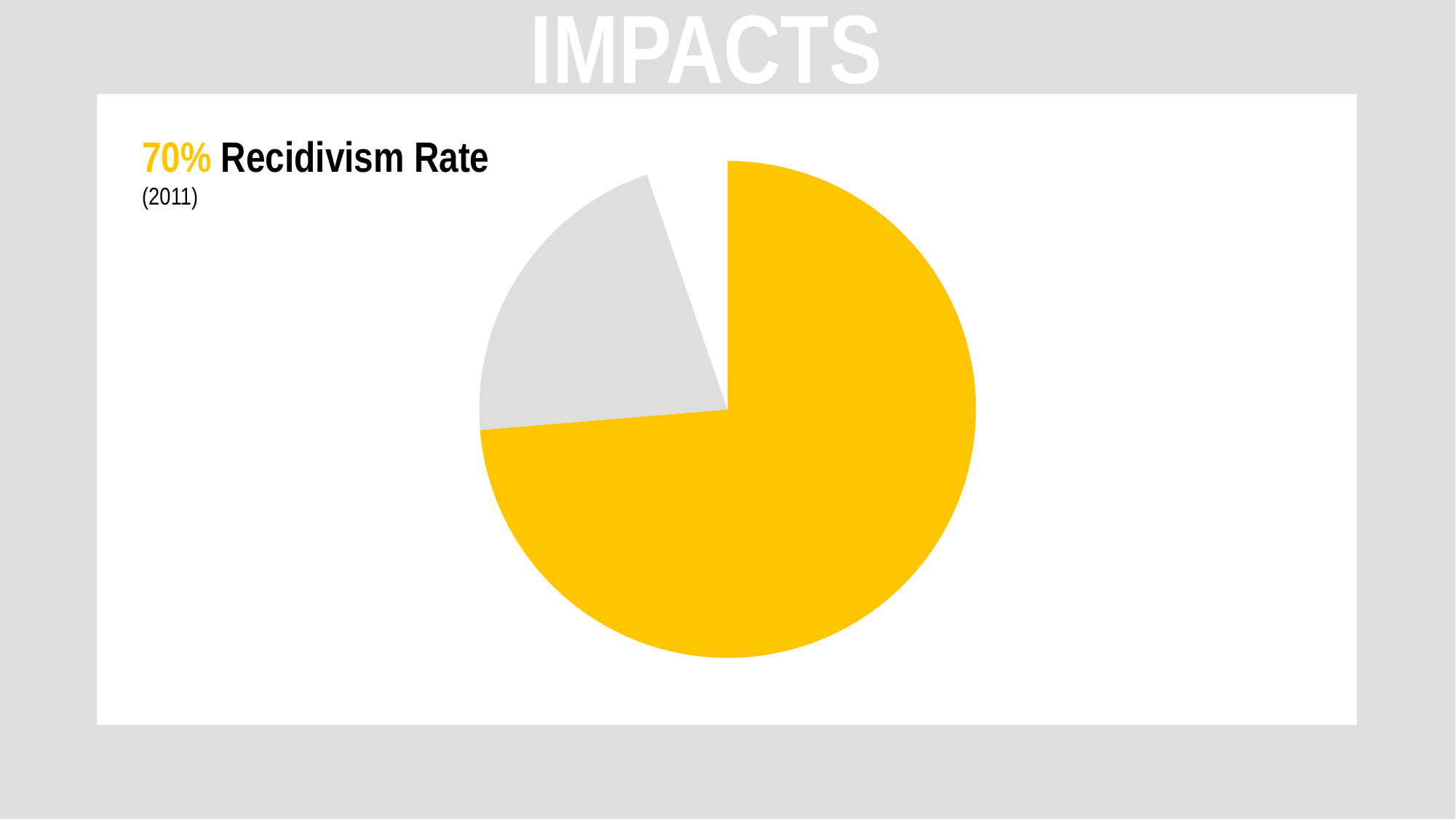
What share of the pie does the yellow slice represent? 70% What kind of chart is shown on the slide? pie chart How many slices does the pie chart have? 3 Which year is given for the recidivism rate shown in the pie chart? 2011 Is the grey slice of the pie greater or less than 50% of the whole? less Which slice is the largest in the pie chart? the yellow slice What rate does the pie chart illustrate, according to the text next to it? Recidivism Rate Which slice of the pie is larger, the yellow one or the grey one? yellow